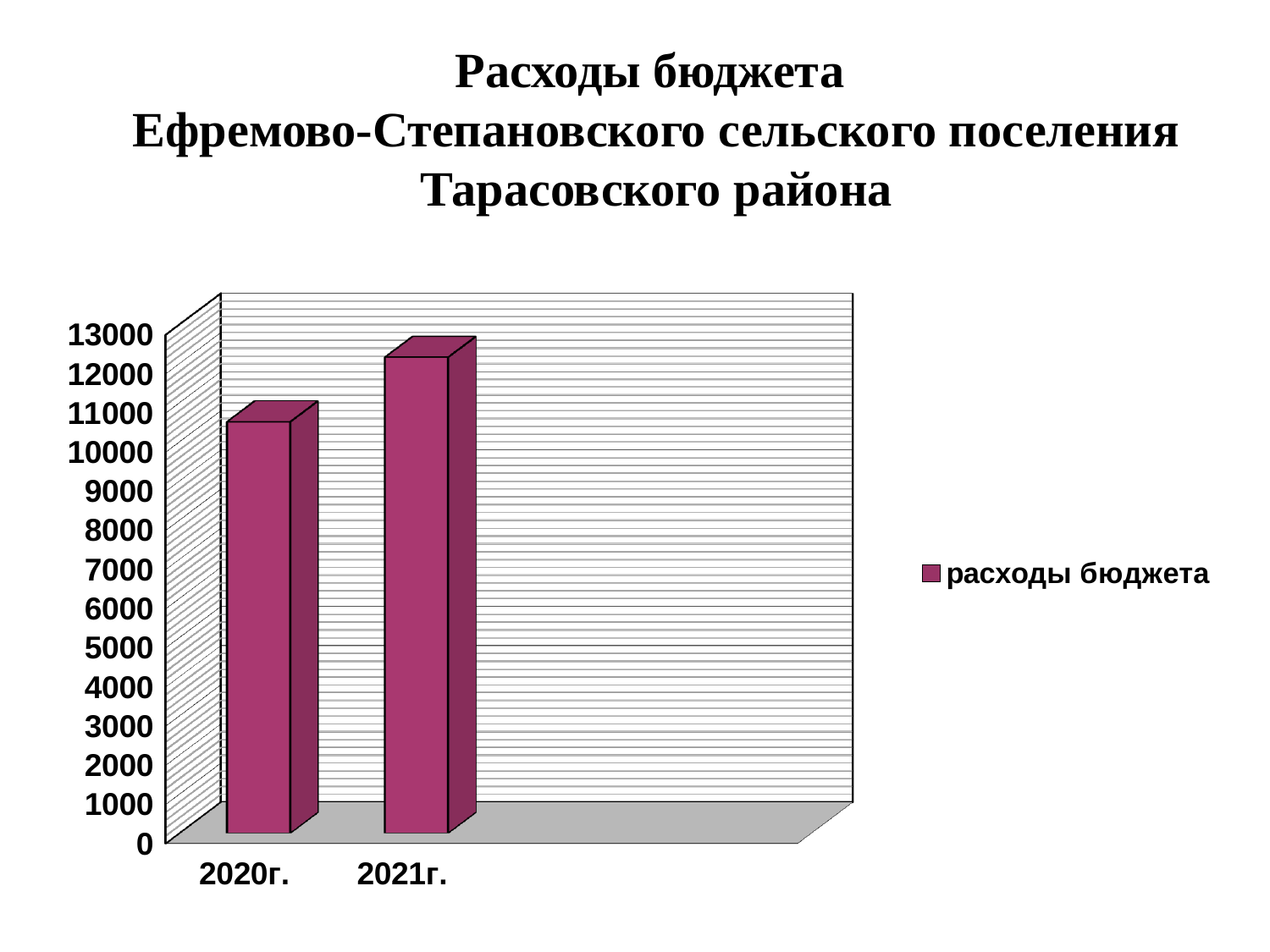
What kind of chart is shown on the slide? bar chart What series name is shown in the chart legend? расходы бюджета How many categories (years) are shown on the x axis of the chart? 2 Is the value for 2020г. greater or less than 10000? greater How many series does the chart legend list? 1 Which category has the highest value in the chart? 2021г. Which year has the higher bar, 2020г. or 2021г.? 2021г. Is the value for 2020г. greater or less than 11000? less Which category has the lowest value in the chart? 2020г. Is the value for 2021г. greater or less than 13000? less Do the values rise or fall from 2020г. to 2021г.? rise